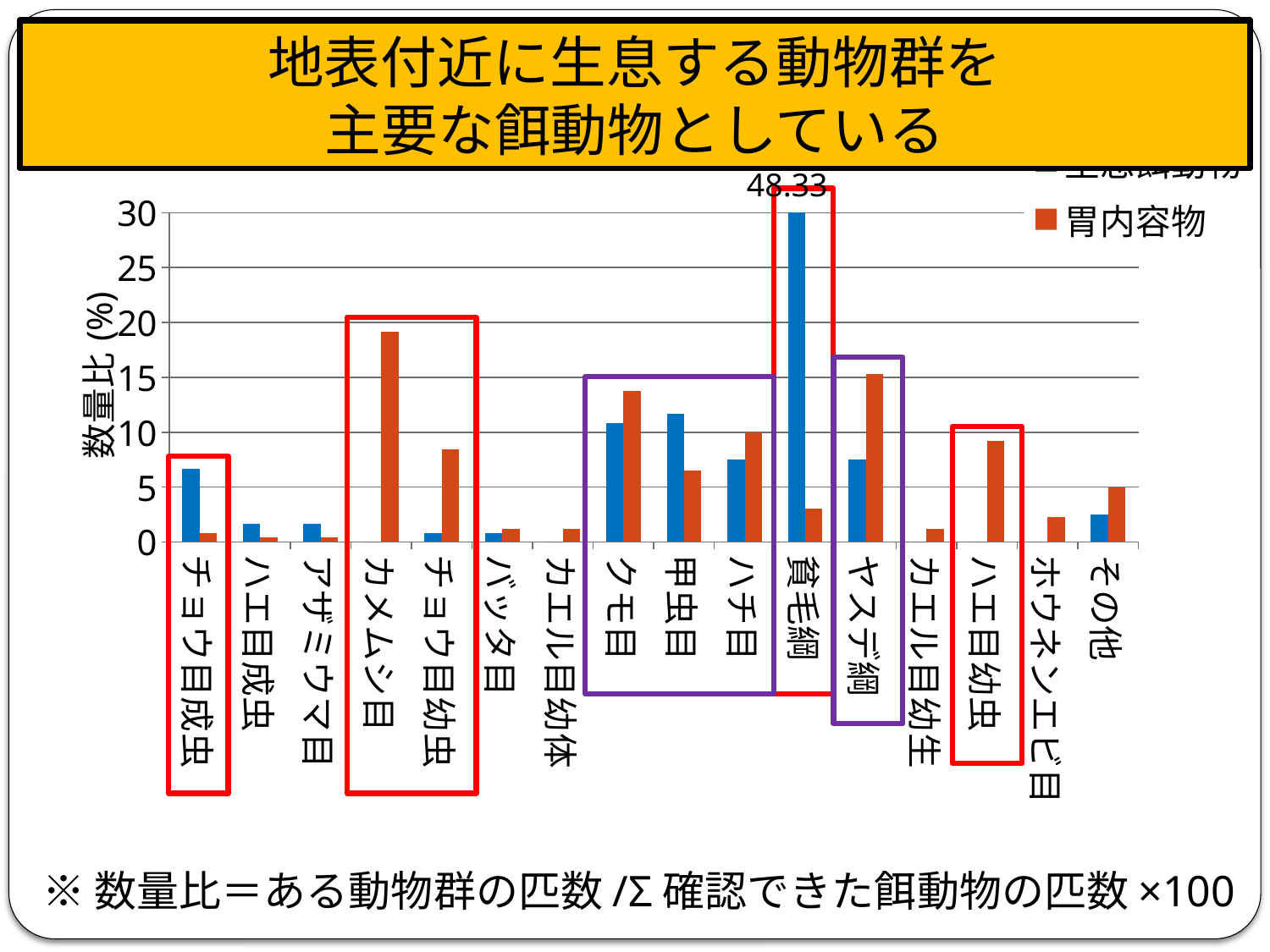
Is the 胃内容物 value for ヤスデ綱 greater or less than 10? greater Which category has the highest 胃内容物 bar? カメムシ目 What value is printed above the blue bar for 貧毛綱? 48.33 How many categories are shown along the x axis of the chart? 16 Which category has the highest blue bar? 貧毛綱 How many series does the chart's legend list? 2 Is the 胃内容物 value for カメムシ目 greater or less than 15? greater For 甲虫目, which series has the larger value, the blue series or 胃内容物? the blue series What kind of chart is shown on the slide? bar chart For ヤスデ綱, which series has the larger value, the blue series or 胃内容物? 胃内容物 What is the label of the chart's y axis? 数量比(%) Is the 胃内容物 value for ハエ目幼虫 greater or less than 5? greater